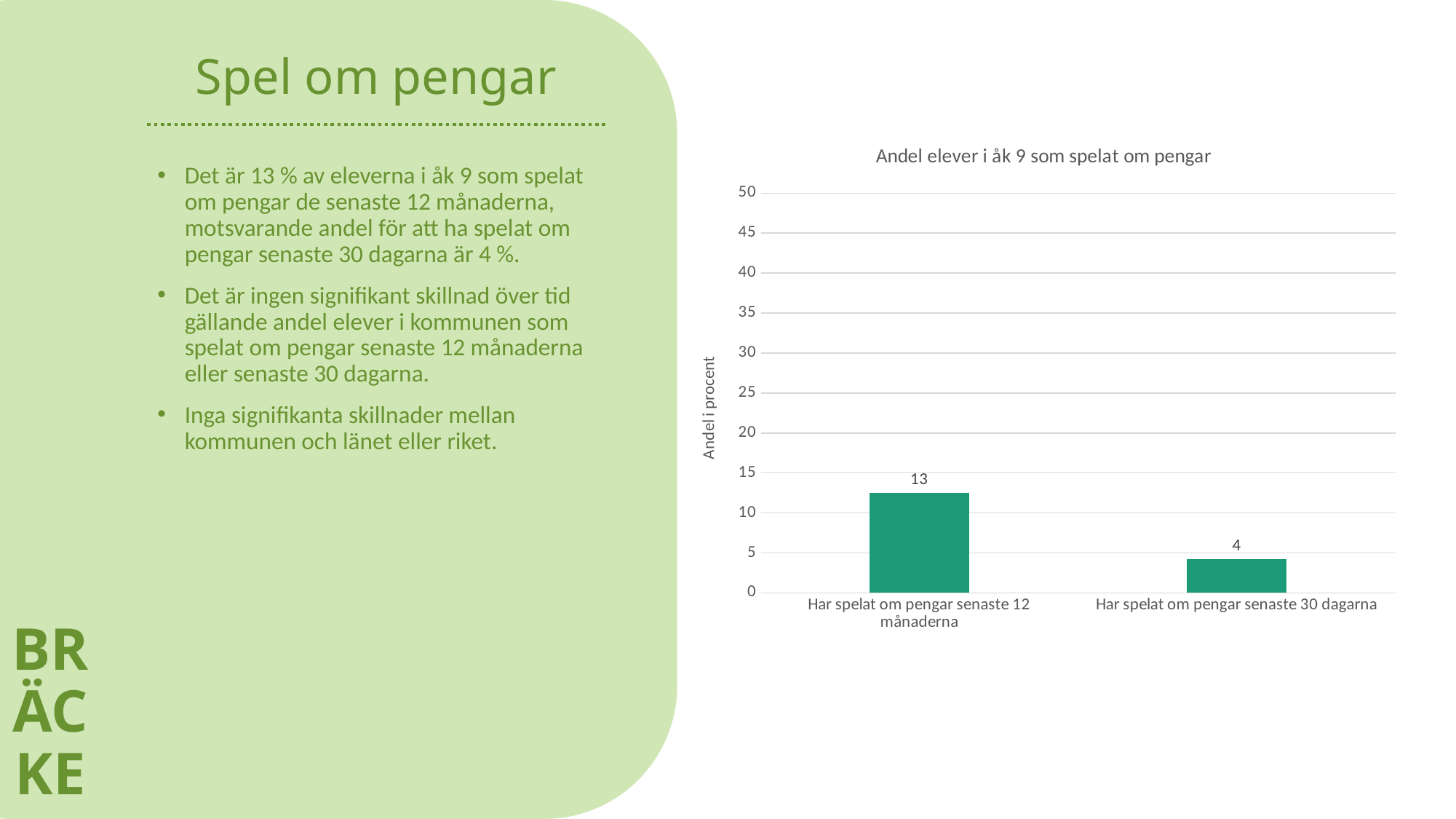
Is the value for "Har spelat om pengar senaste 30 dagarna" greater or less than 5? less What is the label of the vertical axis? Andel i procent What is the difference between the value for "Har spelat om pengar senaste 12 månaderna" and the value for "Har spelat om pengar senaste 30 dagarna"? 9 Is the value for "Har spelat om pengar senaste 12 månaderna" greater or less than 10? greater What is the value for "Har spelat om pengar senaste 30 dagarna"? 4 What is the title of the chart? Andel elever i åk 9 som spelat om pengar What is the value for "Har spelat om pengar senaste 12 månaderna"? 13 Which category has the lowest value? Har spelat om pengar senaste 30 dagarna How many categories are shown on the chart? 2 Which is larger: the value for "Har spelat om pengar senaste 12 månaderna" or the value for "Har spelat om pengar senaste 30 dagarna"? Har spelat om pengar senaste 12 månaderna Which category has the highest value? Har spelat om pengar senaste 12 månaderna What kind of chart is shown on the slide? bar chart